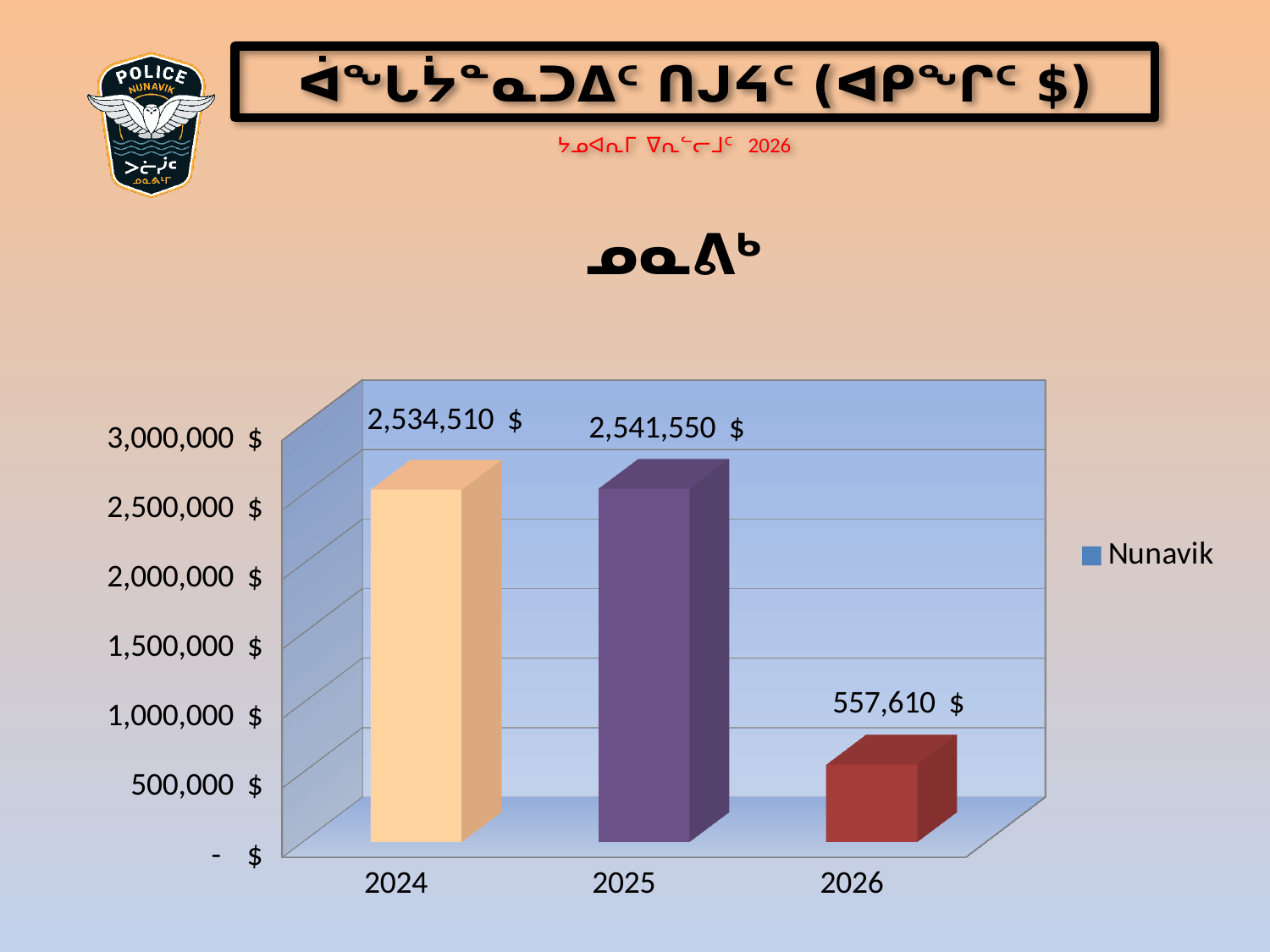
Which is larger, the value for 2024 or the value for 2026? 2024 What is the value for 2026? 557,610 $ Is the value for 2024 greater or less than 2,000,000 $? greater What is the value for 2024? 2,534,510 $ How many years are shown on the x axis? 3 What is the value for 2025? 2,541,550 $ What is the difference between the values for 2025 and 2026? 1,983,940 $ Which year has the lowest value? 2026 How many series does the legend list? 1 What kind of chart is shown? bar chart Is the value for 2026 greater or less than 1,000,000 $? less What is the difference between the values for 2025 and 2024? 7,040 $